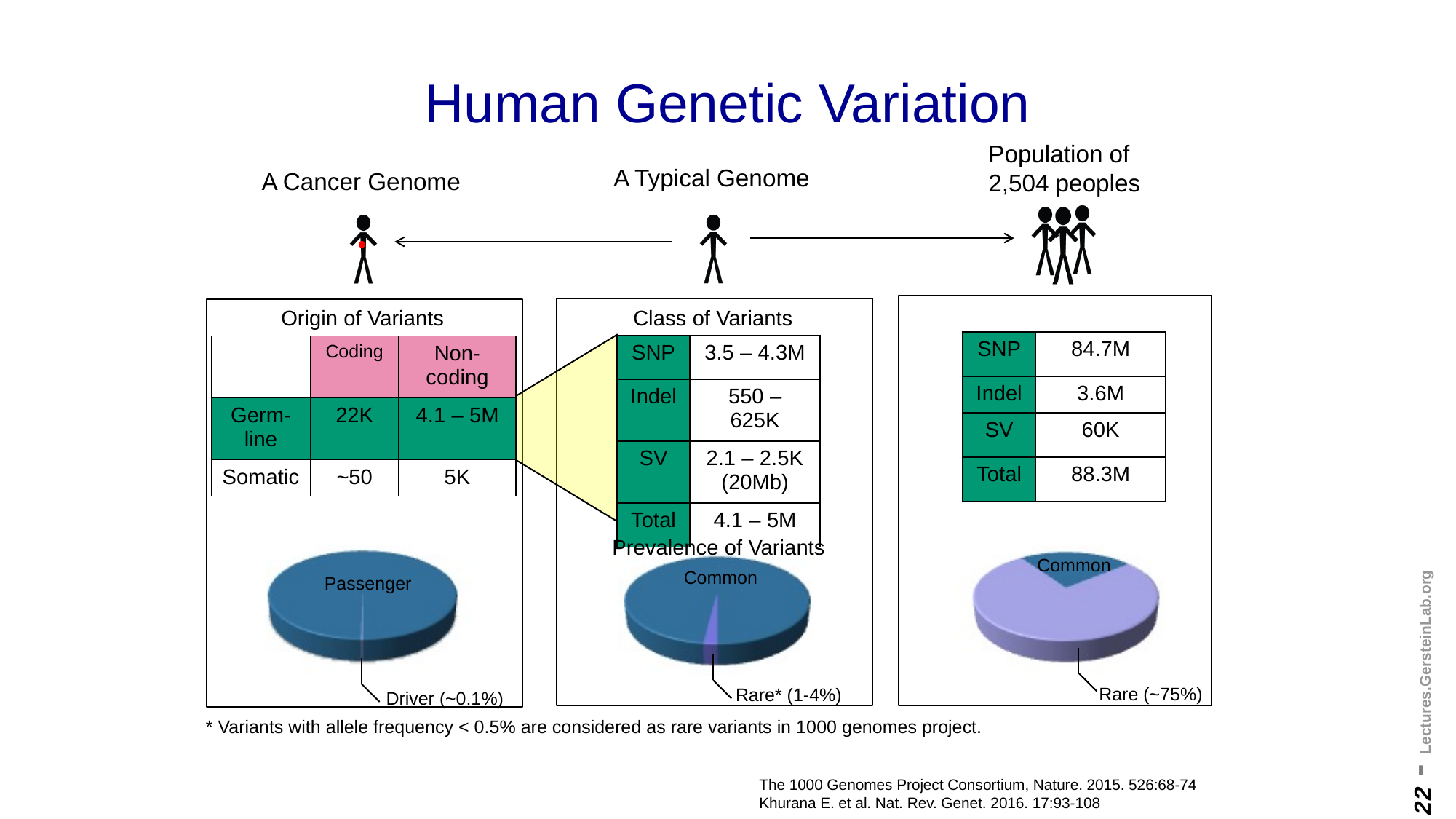
In the "Prevalence of Variants" pie chart under "A Typical Genome", which slice is larger, Common or Rare? Common How many slices does the pie chart under "A Cancer Genome" have? 2 In the "Prevalence of Variants" pie chart under "A Typical Genome", which slice is the smallest? Rare What label is attached to the small slice of the pie chart under "A Cancer Genome"? Driver (~0.1%) How many pie charts are shown on the slide? 3 In the pie chart under "Population of 2,504 peoples", which slice is larger, Common or Rare? Rare What kind of chart is shown under "A Cancer Genome" at the bottom left of the slide? pie chart In the pie chart under "Population of 2,504 peoples", which slice is the largest? Rare In the pie chart under "A Cancer Genome", which slice is larger, Passenger or Driver? Passenger What title is printed above the middle pie chart under "A Typical Genome"? Prevalence of Variants In the pie chart under "A Cancer Genome", which slice is the smallest? Driver How many slices does the pie chart under "Population of 2,504 peoples" have? 2